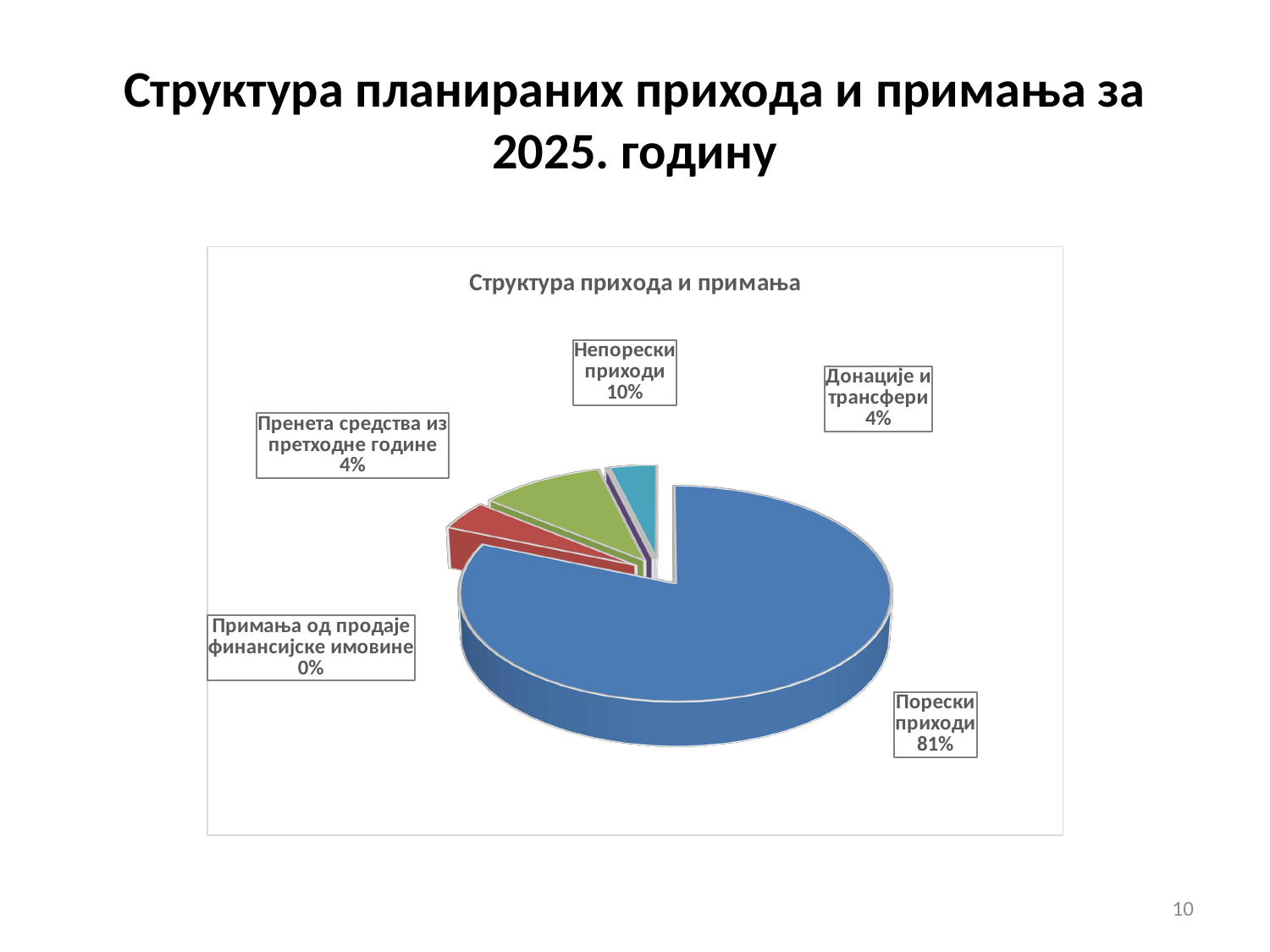
What kind of chart is shown on the slide? Pie chart Which category has the smallest slice of the pie? Примања од продаје финансијске имовине What share of the pie does Пренета средства из претходне године have? 4% What share of the pie does Примања од продаје финансијске имовине have? 0% Which is larger, Непорески приходи or Донације и трансфери? Непорески приходи What share of the pie does Непорески приходи have? 10% What is the title of the chart? Структура прихода и примања Which category has the largest slice of the pie? Порески приходи What is the difference in percentage points between Порески приходи and Непорески приходи? 71 How many categories are shown in the pie chart? 5